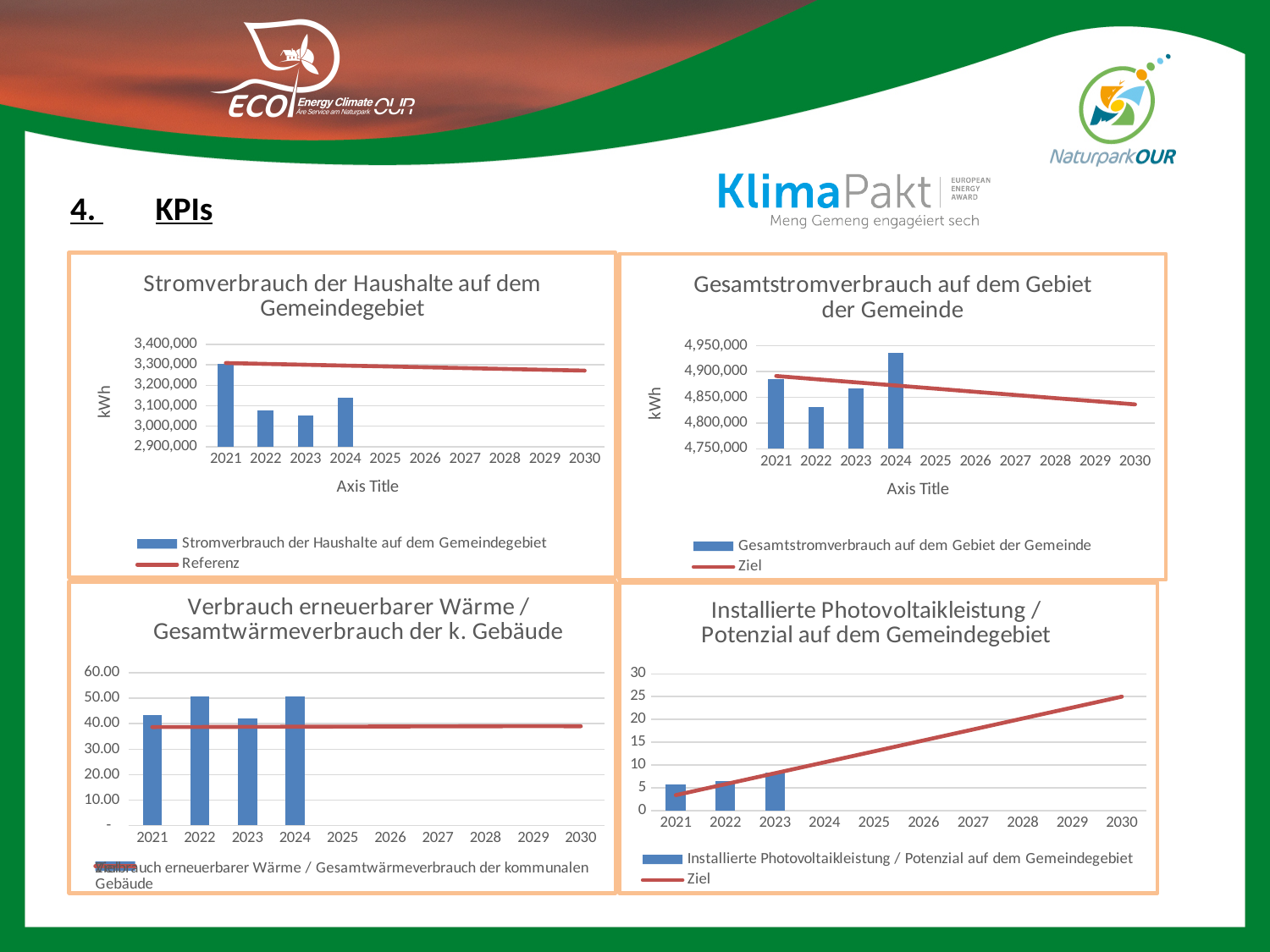
In the chart titled 'Verbrauch erneuerbarer Wärme / Gesamtwärmeverbrauch der k. Gebäude', is the value for 2021 greater or less than 40.00? greater In the chart titled 'Gesamtstromverbrauch auf dem Gebiet der Gemeinde', which year has the highest bar? 2024 In the chart titled 'Verbrauch erneuerbarer Wärme / Gesamtwärmeverbrauch der k. Gebäude', is the bar for 2022 larger or smaller than the bar for 2023? larger In the chart titled 'Installierte Photovoltaikleistung / Potenzial auf dem Gemeindegebiet', how many years have a bar plotted? 3 In the chart titled 'Gesamtstromverbrauch auf dem Gebiet der Gemeinde', does the 'Ziel' line rise or fall from 2021 to 2030? fall In the chart titled 'Stromverbrauch der Haushalte auf dem Gemeindegebiet', is the value for 2022 greater or less than 3,100,000? less In the chart titled 'Gesamtstromverbrauch auf dem Gebiet der Gemeinde', is the value for 2024 greater or less than 4,900,000? greater How many series does the legend of the chart titled 'Installierte Photovoltaikleistung / Potenzial auf dem Gemeindegebiet' list? 2 In the chart titled 'Gesamtstromverbrauch auf dem Gebiet der Gemeinde', which year has the lowest bar? 2022 In the chart titled 'Installierte Photovoltaikleistung / Potenzial auf dem Gemeindegebiet', does the 'Ziel' line rise or fall from 2021 to 2030? rise In the chart titled 'Stromverbrauch der Haushalte auf dem Gemeindegebiet', which year has the highest bar? 2021